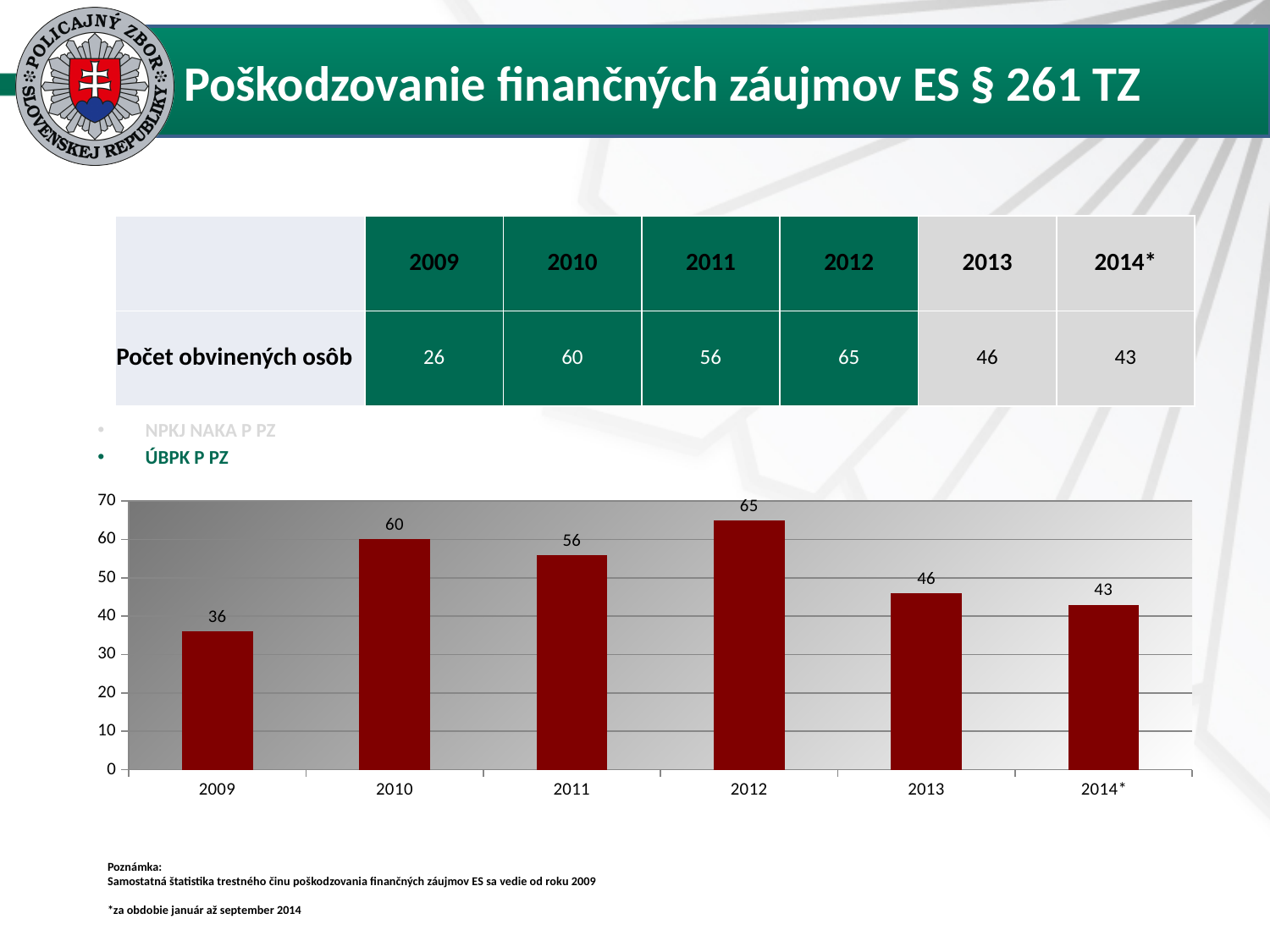
What type of chart is shown on the slide? bar chart What is the difference between the chart values for 2012 and 2013? 19 What is the difference between the chart values for 2010 and 2011? 4 In the chart, which is larger, the value for 2010 or the value for 2011? 2010 What value does the bar for 2009 show in the chart? 36 Which year has the lowest bar in the chart? 2009 How many bars are plotted in the chart? 6 Is the value for 2013 in the chart greater or less than 50? less What value does the bar for 2014* show in the chart? 43 Which year has the highest bar in the chart? 2012 Do the chart values rise or fall from 2012 to 2014*? fall What value does the bar for 2012 show in the chart? 65